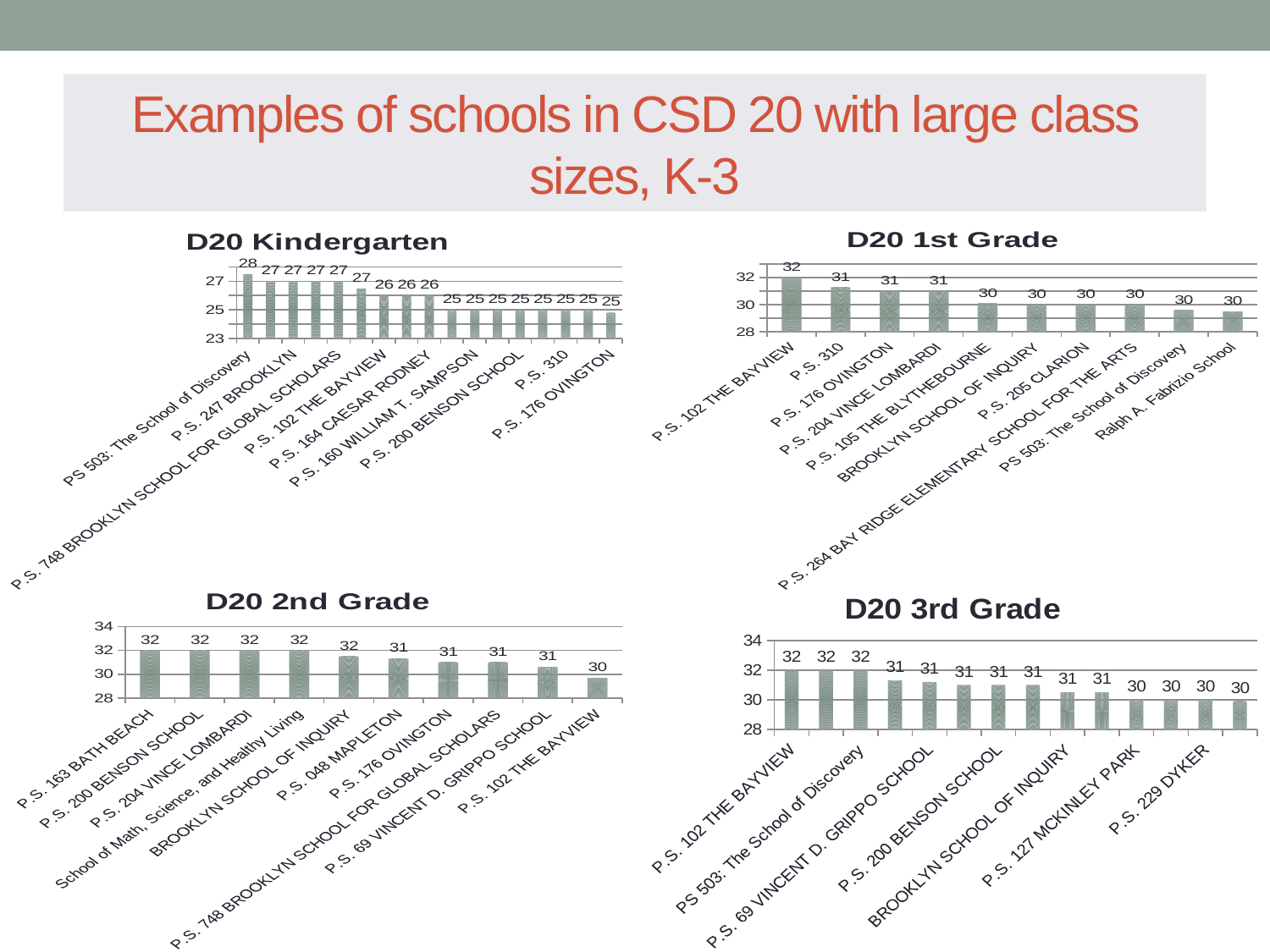
In the D20 2nd Grade chart, what is the value for P.S. 102 THE BAYVIEW? 30 In the D20 2nd Grade chart, what is the difference between the values for P.S. 163 BATH BEACH and P.S. 102 THE BAYVIEW? 2 How many bars are plotted in the D20 Kindergarten chart? 17 What type of chart is the D20 3rd Grade chart? Bar chart In the D20 1st Grade chart, what is the value for Ralph A. Fabrizio School? 30 In the D20 Kindergarten chart, what is the highest class size shown? 28 In the D20 2nd Grade chart, which is larger, the value for P.S. 048 MAPLETON or for P.S. 102 THE BAYVIEW? P.S. 048 MAPLETON In the D20 2nd Grade chart, which school has the lowest value? P.S. 102 THE BAYVIEW In the D20 3rd Grade chart, what is the highest value shown? 32 In the D20 1st Grade chart, what is the value for P.S. 102 THE BAYVIEW? 32 In the D20 1st Grade chart, what is the value for P.S. 310? 31 How many schools are plotted in the D20 1st Grade chart? 10